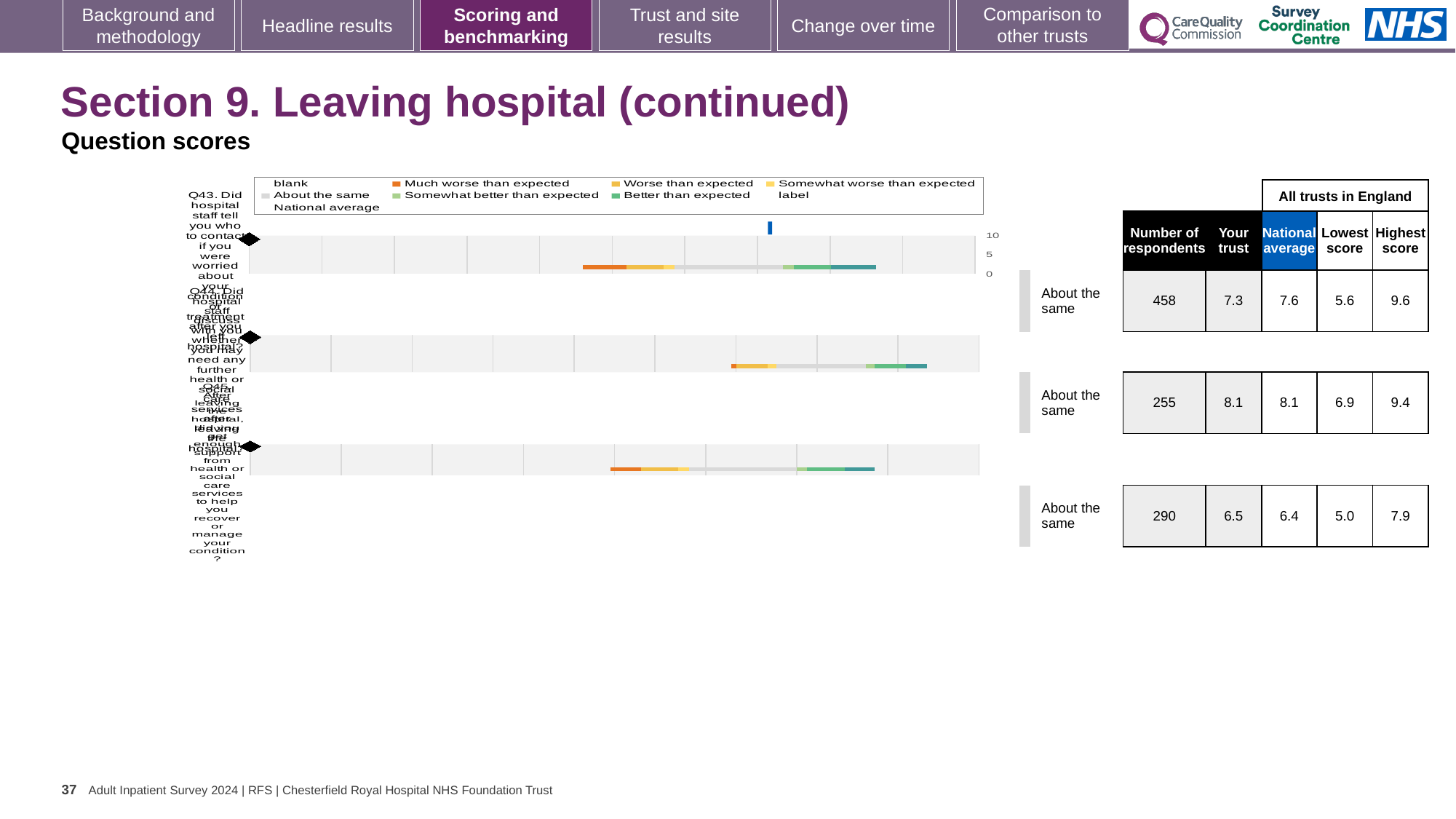
For the bottom chart (Q45), what is the highest score among all trusts in England? 7.9 For the bottom chart (Q45), what is the trust's score? 6.5 For the middle chart (Q44), what is the trust's score? 8.1 For the bottom chart (Q45), is the trust's score larger or smaller than the national average? larger For the top chart (Q43), what is the difference between the national average and the trust's score? 0.3 For the top chart (Q43), what is the national average score? 7.6 What benchmark category is shown next to each of the three charts? About the same Which of the three charts has the lowest trust score? Q45 (bottom chart) How many questions (charts) are shown on the slide? 3 For the top chart (Q43, who to contact if worried after leaving hospital), what is the trust's score? 7.3 What kind of chart is used to show the question scores on this slide? bar chart Which of the three charts has the highest trust score? Q44 (middle chart)